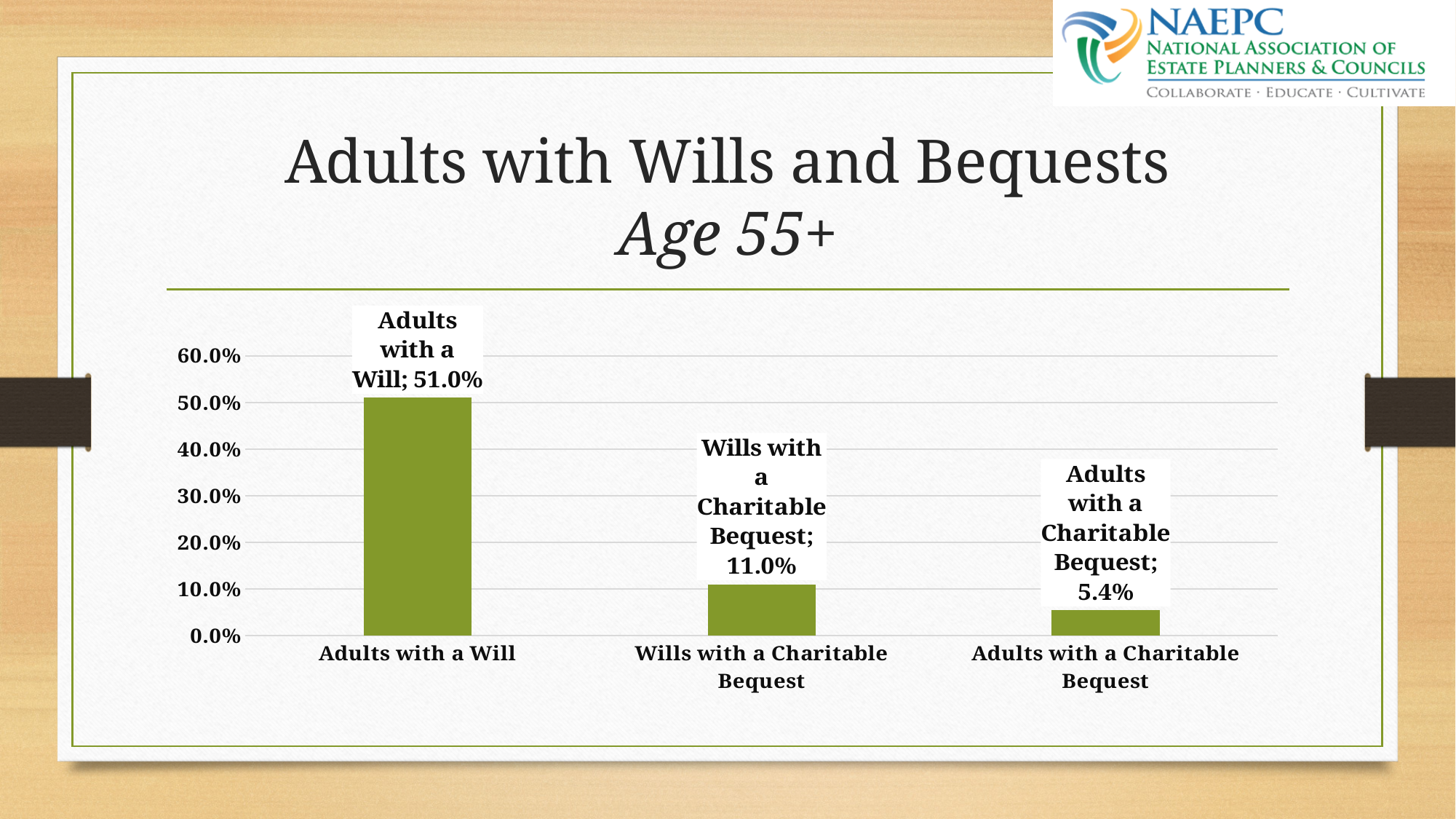
What is the difference between the values for Wills with a Charitable Bequest and Adults with a Charitable Bequest? 5.6% What kind of chart is shown on the slide? bar chart What is the title of the slide containing the chart? Adults with Wills and Bequests Age 55+ Which category has the highest value? Adults with a Will Which category has the lowest value? Adults with a Charitable Bequest What is the value for Wills with a Charitable Bequest? 11.0% What is the value for Adults with a Will? 51.0% What is the value for Adults with a Charitable Bequest? 5.4% How many categories are shown in the chart? 3 Which is larger, the value for Wills with a Charitable Bequest or the value for Adults with a Charitable Bequest? Wills with a Charitable Bequest Is the value for Adults with a Will greater or less than 40.0%? greater What is the difference between the values for Adults with a Will and Wills with a Charitable Bequest? 40.0%